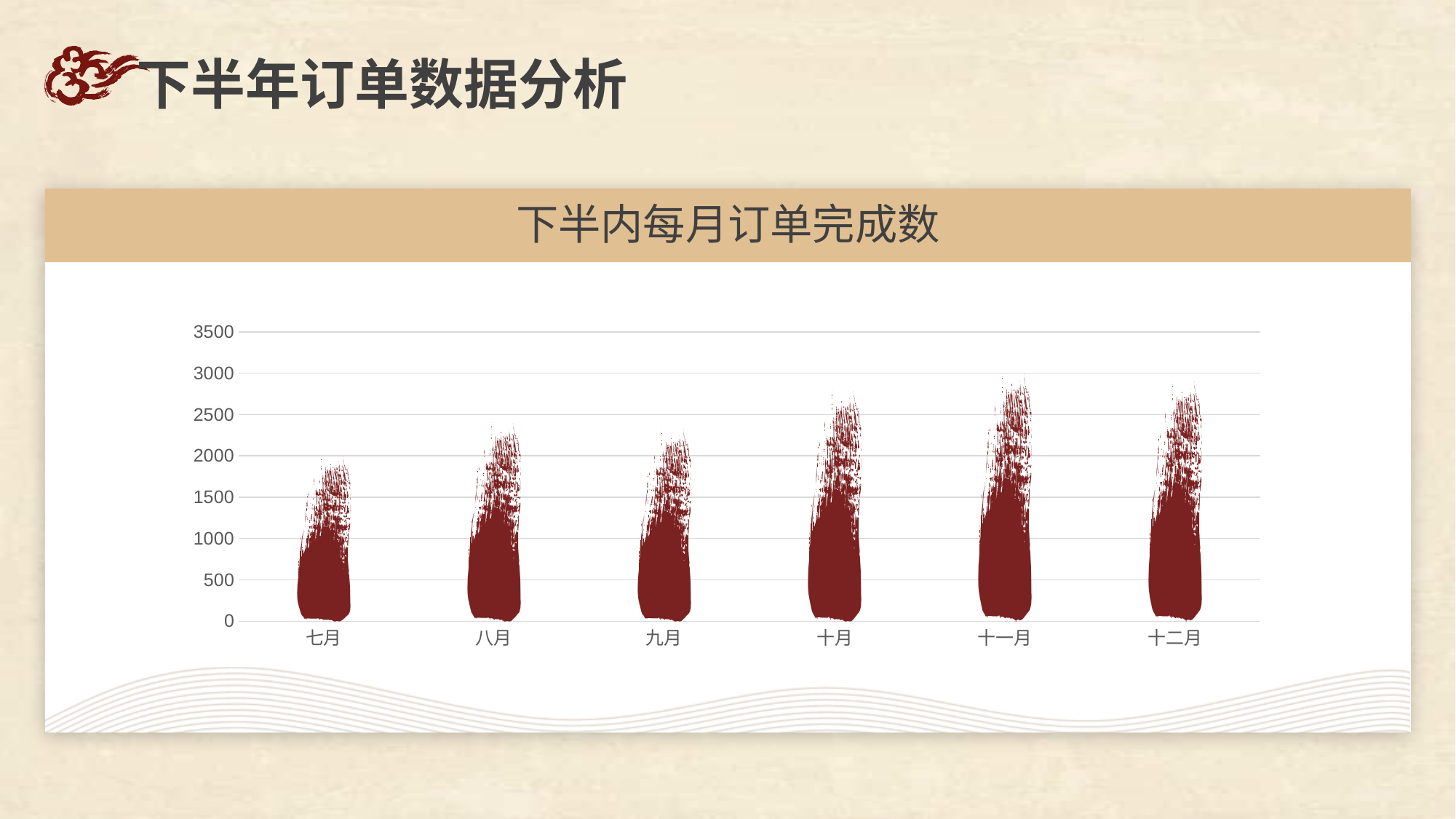
What kind of chart is shown on the slide? bar chart What is the title of the chart? 下半内每月订单完成数 Which month has the lowest order completion count? 七月 Is the value for 七月 greater or less than 2500? less Is the value for 八月 greater or less than 2000? greater Is the value for 七月 greater or less than 1500? greater Which is larger, the value for 十月 or the value for 七月? 十月 How many months are shown on the x axis of the chart? 6 Do the values generally rise or fall from 七月 to 十二月? rise Which is larger, the value for 十一月 or the value for 八月? 十一月